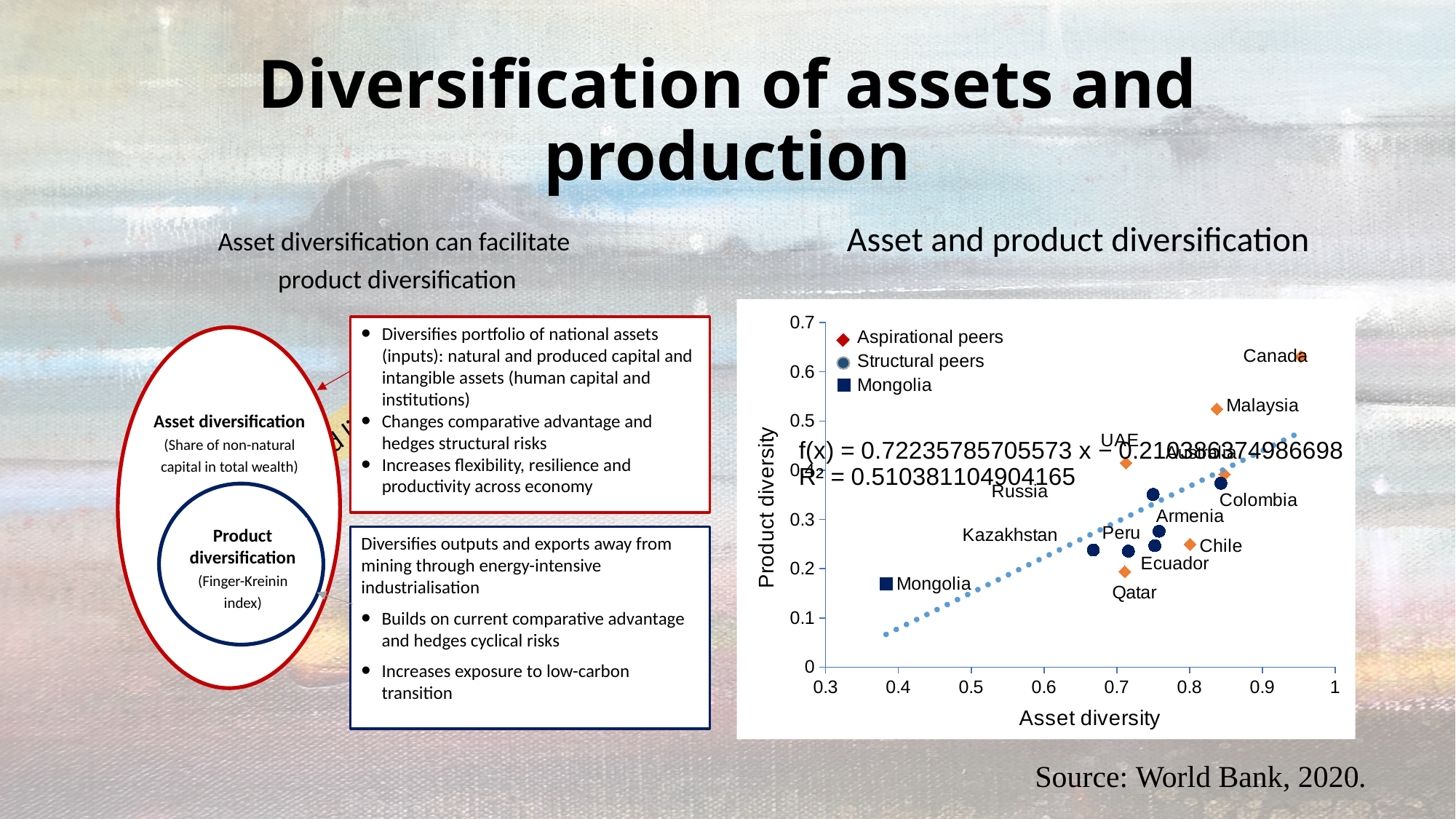
In the "Asset and product diversification" chart, which has the higher asset diversity, Mongolia or Kazakhstan? Kazakhstan In the "Asset and product diversification" chart, does product diversity generally rise or fall as asset diversity increases along the x axis? rise In the "Asset and product diversification" chart, is the product diversity value for Canada greater or less than 0.6? greater In the "Asset and product diversification" chart, is the asset diversity value for Mongolia greater or less than 0.4? less In the "Asset and product diversification" chart, which has the higher product diversity, Canada or Malaysia? Canada In the "Asset and product diversification" chart, which country has the lowest asset diversity? Mongolia What is the label of the x axis of the "Asset and product diversification" chart? Asset diversity How many series does the legend of the "Asset and product diversification" chart list? 3 In the "Asset and product diversification" chart, which country has the highest product diversity? Canada In the "Asset and product diversification" chart, is the product diversity value for Malaysia greater or less than 0.5? greater What kind of chart is shown under the title "Asset and product diversification"? scatter chart